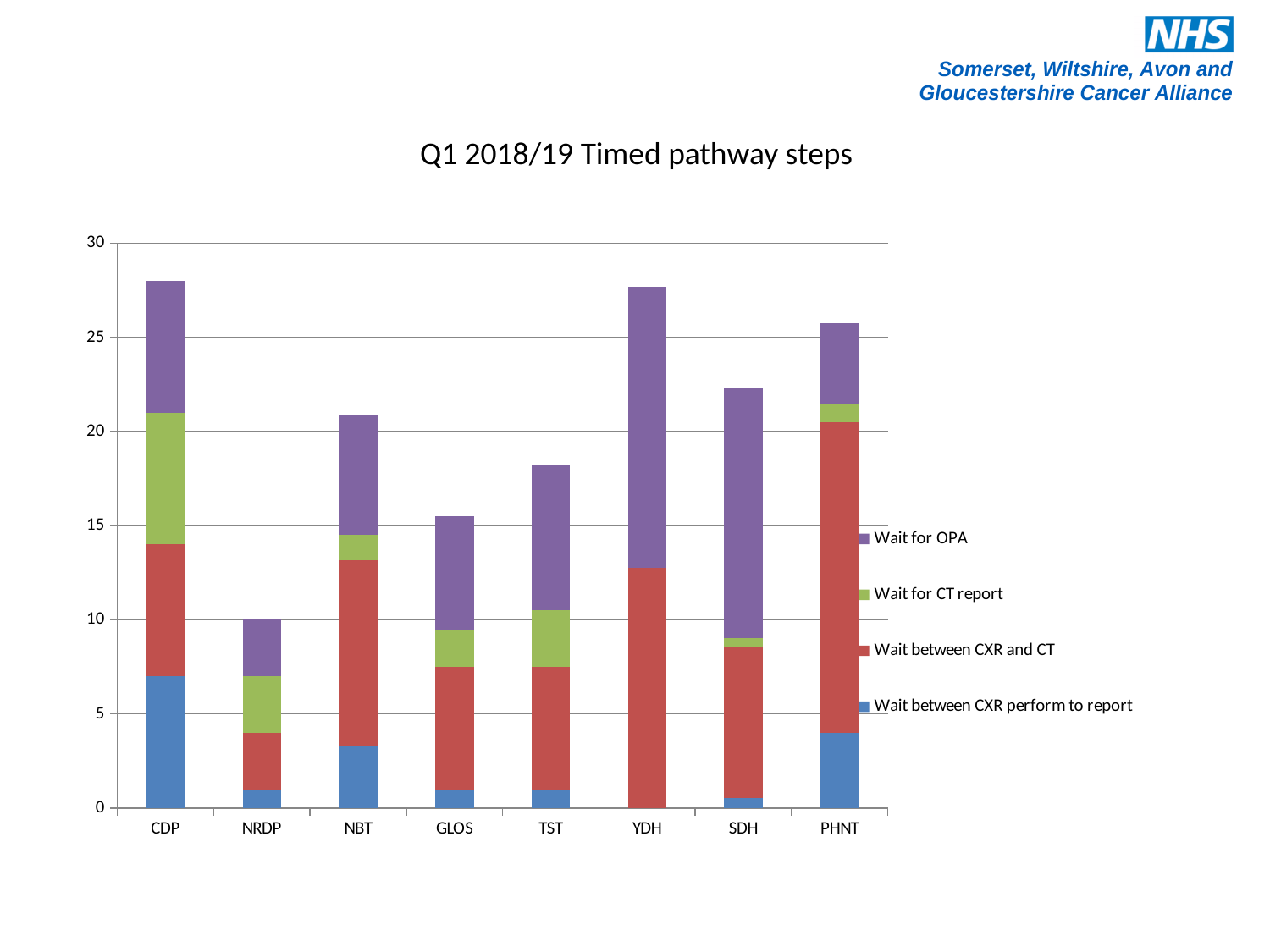
Which organisation has the largest 'Wait between CXR perform to report' segment? CDP Which organisation has the largest 'Wait between CXR and CT' segment? PHNT Which organisation has the lowest total stacked bar? NRDP Is the total bar for NRDP greater or less than 15? less What is the title of the chart? Q1 2018/19 Timed pathway steps What kind of chart is shown on the slide? Stacked bar chart Is the total bar for CDP greater or less than 25? greater Which colour represents 'Wait for OPA' in the chart? Purple How many series does the legend list? 4 Which has the larger total bar, YDH or GLOS? YDH How many organisations (categories) are shown along the x axis? 8 Is the total bar for GLOS greater or less than 20? less